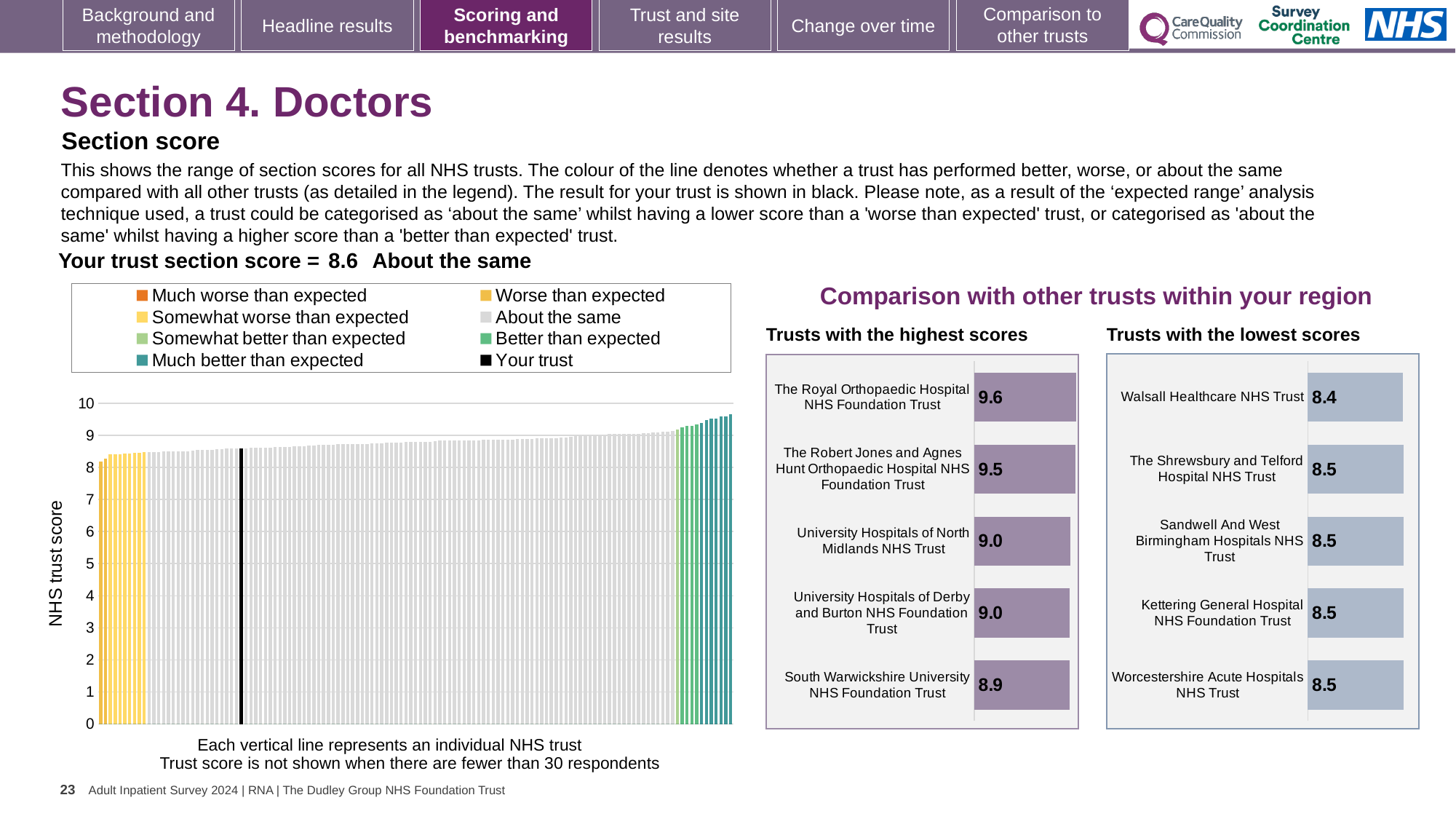
In the 'Trusts with the lowest scores' chart, which trust has the lowest score? Walsall Healthcare NHS Trust What is the y-axis label of the left-hand chart? NHS trust score In the 'Trusts with the highest scores' chart, which trust has the lowest score? South Warwickshire University NHS Foundation Trust In the 'Trusts with the highest scores' chart, what is the score for The Royal Orthopaedic Hospital NHS Foundation Trust? 9.6 In the left-hand chart, do the trust scores rise or fall from left to right along the x axis? rise In the left-hand chart, what is the section score for your trust? 8.6 In the 'Trusts with the highest scores' chart, what is the difference between the scores of The Royal Orthopaedic Hospital NHS Foundation Trust and South Warwickshire University NHS Foundation Trust? 0.7 In the 'Trusts with the lowest scores' chart, what is the score for Kettering General Hospital NHS Foundation Trust? 8.5 In the left-hand chart, is the value for your trust greater or less than 8? greater What kind of chart is the large chart on the left showing NHS trust scores? bar chart How many entries does the legend of the left-hand chart list? 8 In the 'Trusts with the highest scores' chart, how many trusts are shown? 5